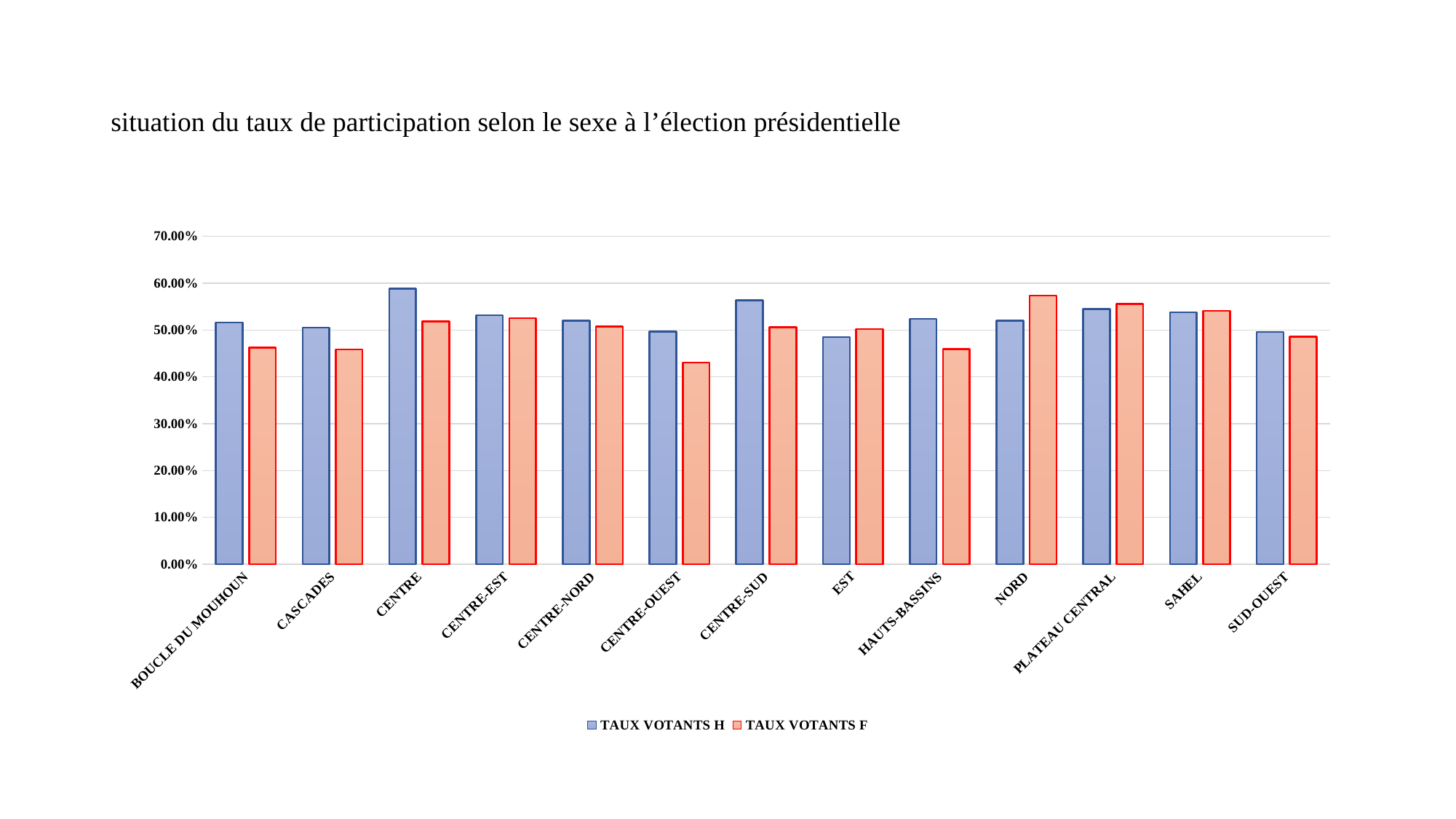
Is the TAUX VOTANTS F value for CENTRE-OUEST greater or less than 50.00%? less Which region has the highest value for TAUX VOTANTS F? NORD Which region has the highest value for TAUX VOTANTS H? CENTRE How many regions are shown on the x axis? 13 Which region has the lowest value for TAUX VOTANTS F? CENTRE-OUEST How many series does the legend list? 2 For CENTRE, which is larger: TAUX VOTANTS H or TAUX VOTANTS F? TAUX VOTANTS H For NORD, which is larger: TAUX VOTANTS H or TAUX VOTANTS F? TAUX VOTANTS F Is the TAUX VOTANTS F value for BOUCLE DU MOUHOUN greater or less than 50.00%? less What kind of chart is shown on the slide? bar chart Is the TAUX VOTANTS H value for CENTRE greater or less than 50.00%? greater What are the two series named in the legend? TAUX VOTANTS H and TAUX VOTANTS F